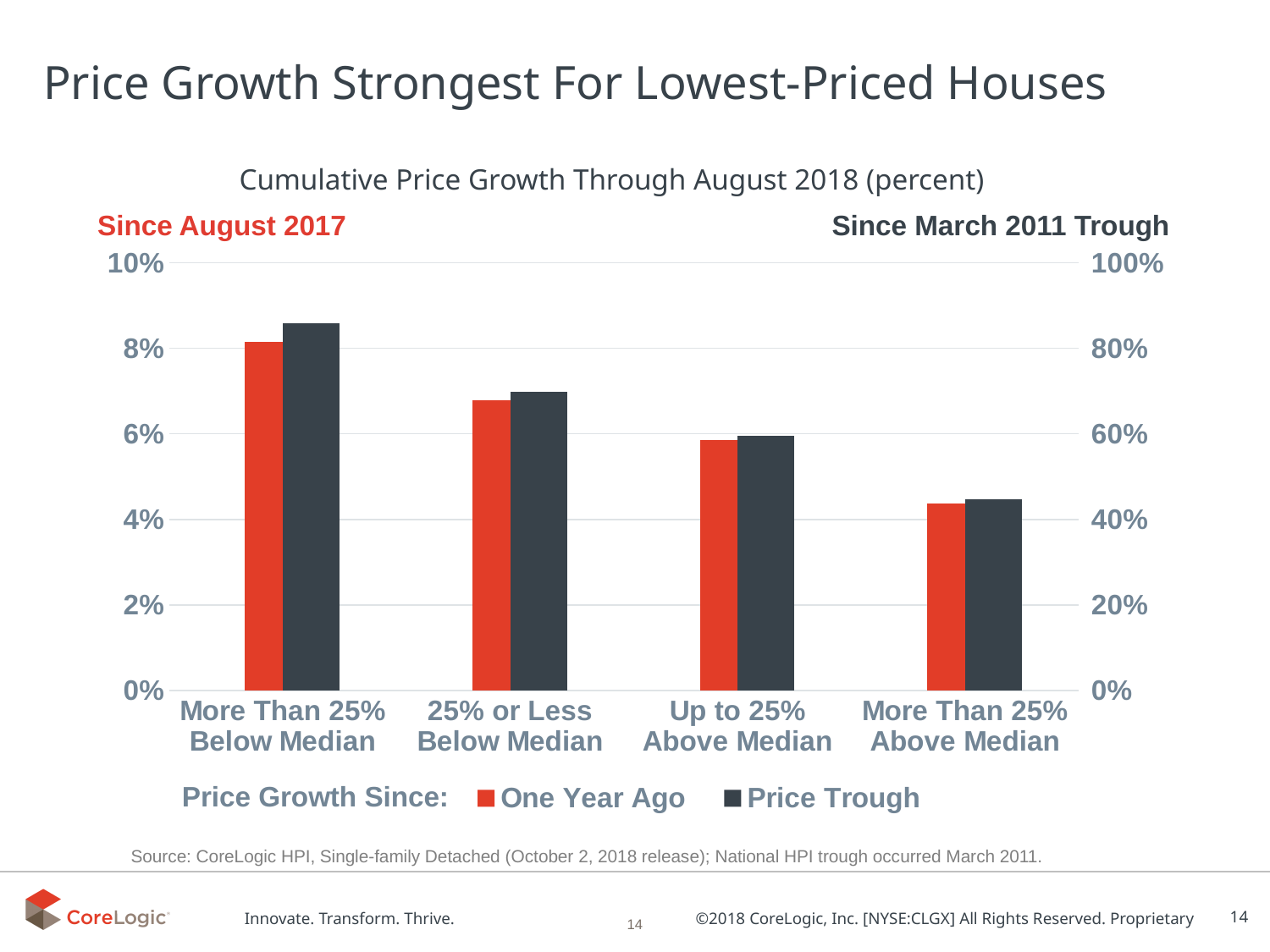
Which has the larger One Year Ago value: More Than 25% Below Median or Up to 25% Above Median? More Than 25% Below Median What kind of chart is shown on the slide? bar chart Do the One Year Ago values rise or fall moving from left to right across the categories? fall Which category has the lowest Price Trough price growth? More Than 25% Above Median How many price-tier categories are shown on the x axis? 4 What label is given to the right-hand vertical axis? Since March 2011 Trough How many series does the legend list? 2 Is the One Year Ago value for More Than 25% Above Median greater or less than 6%? less Is the Price Trough value for More Than 25% Above Median greater or less than 60%? less Which category has the highest One Year Ago price growth? More Than 25% Below Median Is the Price Trough value for More Than 25% Below Median greater or less than 80%? greater